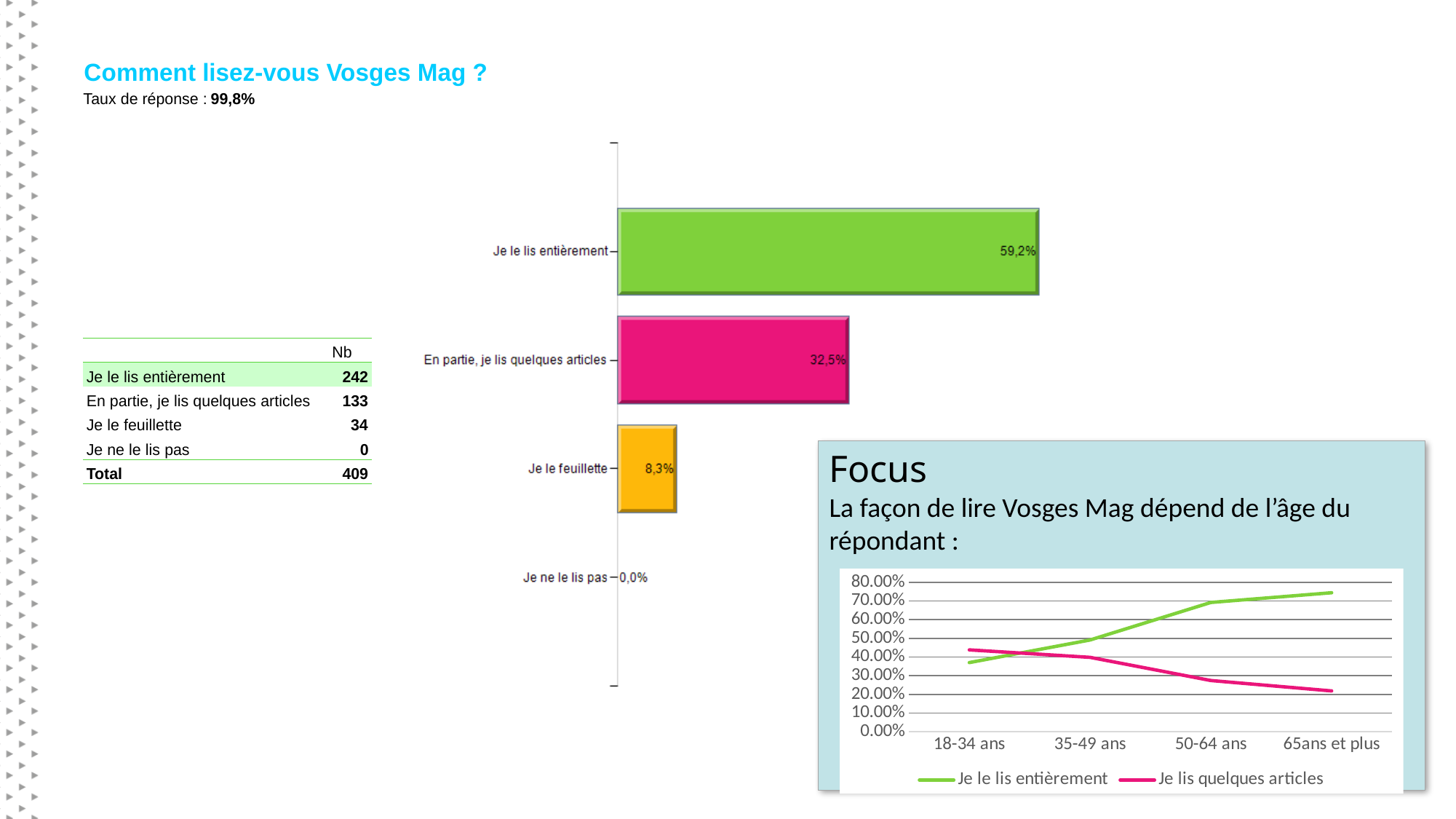
In the horizontal bar chart, how many categories are shown? 4 In the horizontal bar chart, what is the value for "Je le lis entièrement"? 59,2% In the Focus line chart, which series is higher for 50-64 ans, "Je le lis entièrement" or "Je lis quelques articles"? Je le lis entièrement In the horizontal bar chart, which category has the highest value? Je le lis entièrement In the Focus line chart, how many series does the legend list? 2 What kind of chart is the large chart in the middle of the slide? Bar chart In the horizontal bar chart, which category has the lowest value? Je ne le lis pas In the horizontal bar chart, what is the difference between "Je le lis entièrement" and "En partie, je lis quelques articles"? 26,7% In the Focus line chart, does the "Je le lis entièrement" line rise or fall from 18-34 ans to 65ans et plus? Rises In the horizontal bar chart, what is the value for "Je le feuillette"? 8,3% In the horizontal bar chart, what is the value for "En partie, je lis quelques articles"? 32,5% In the Focus line chart, is the value of "Je lis quelques articles" for 65ans et plus greater or less than 30.00%? less